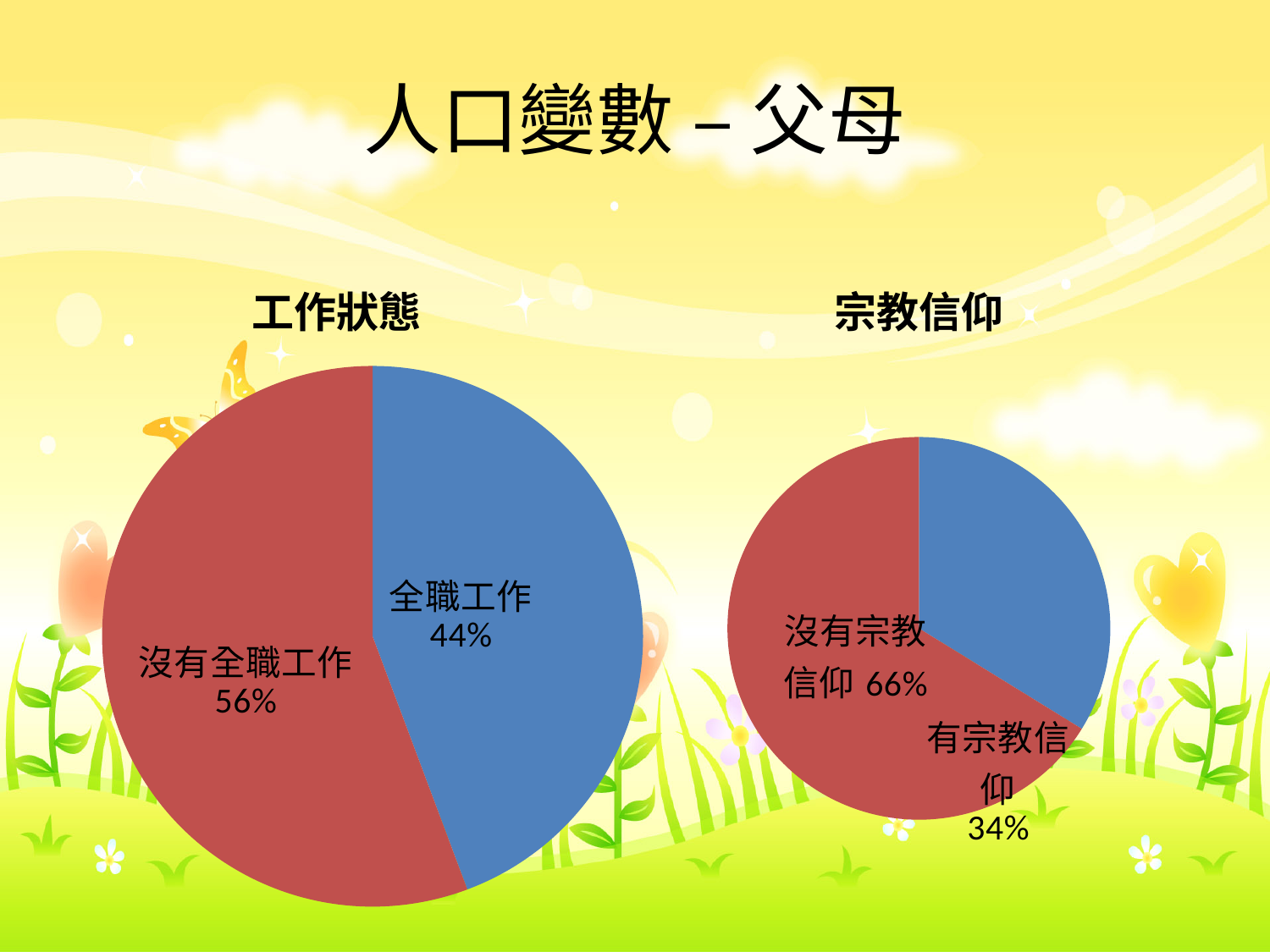
In the 宗教信仰 chart, what percentage is labelled 有宗教信仰? 34% How many slices does the 宗教信仰 chart have? 2 What kind of chart is the 工作狀態 chart? Pie chart In the 工作狀態 chart, what percentage is labelled 沒有全職工作? 56% In the 宗教信仰 chart, what percentage is labelled 沒有宗教信仰? 66% In the 工作狀態 chart, which slice is the largest? 沒有全職工作 In the 宗教信仰 chart, which is larger, 沒有宗教信仰 or 有宗教信仰? 沒有宗教信仰 In the 宗教信仰 chart, what is the difference in percentage points between 沒有宗教信仰 and 有宗教信仰? 32 In the 宗教信仰 chart, which slice is the smallest? 有宗教信仰 What is the title of the chart on the right of the slide? 宗教信仰 In the 工作狀態 chart, what percentage is labelled 全職工作? 44% In the 工作狀態 chart, what is the difference in percentage points between 沒有全職工作 and 全職工作? 12